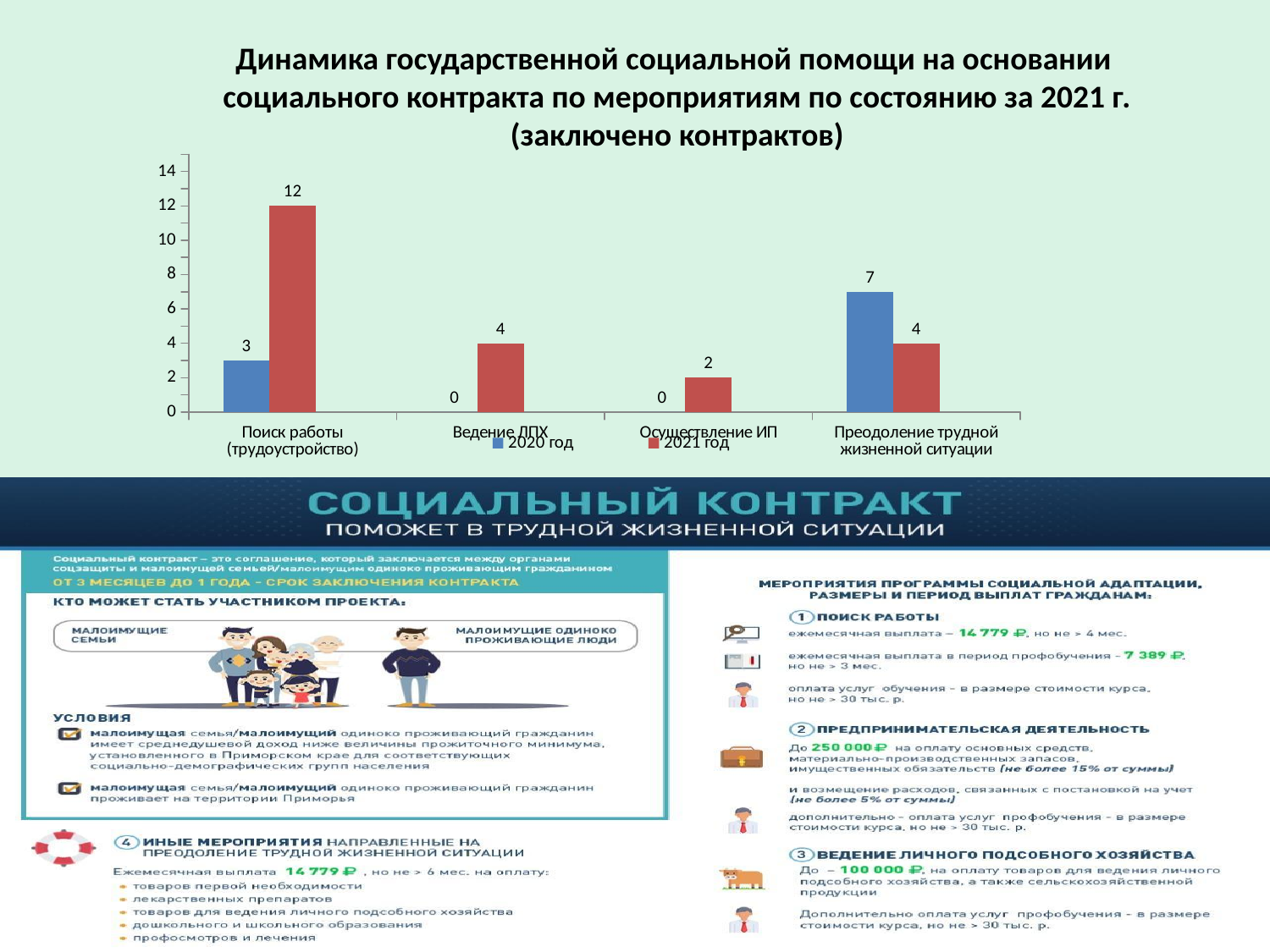
What is the value for 2020 год in the category Осуществление ИП? 0 How many series does the chart legend list? 2 What is the difference between the 2021 год and 2020 год values for Поиск работы (трудоустройство)? 9 What is the value for 2021 год in the category Ведение ЛПХ? 4 How many categories are shown on the x axis of the chart? 4 Which category has the lowest value for 2021 год? Осуществление ИП What is the value for 2020 год in the category Преодоление трудной жизненной ситуации? 7 Which is larger for Преодоление трудной жизненной ситуации: the 2020 год value or the 2021 год value? 2020 год Is the 2021 год value for Поиск работы (трудоустройство) greater or less than 10? greater Which category has the highest value for 2021 год? Поиск работы (трудоустройство) What type of chart is shown on the slide? bar chart What is the value for 2021 год in the category Поиск работы (трудоустройство)? 12